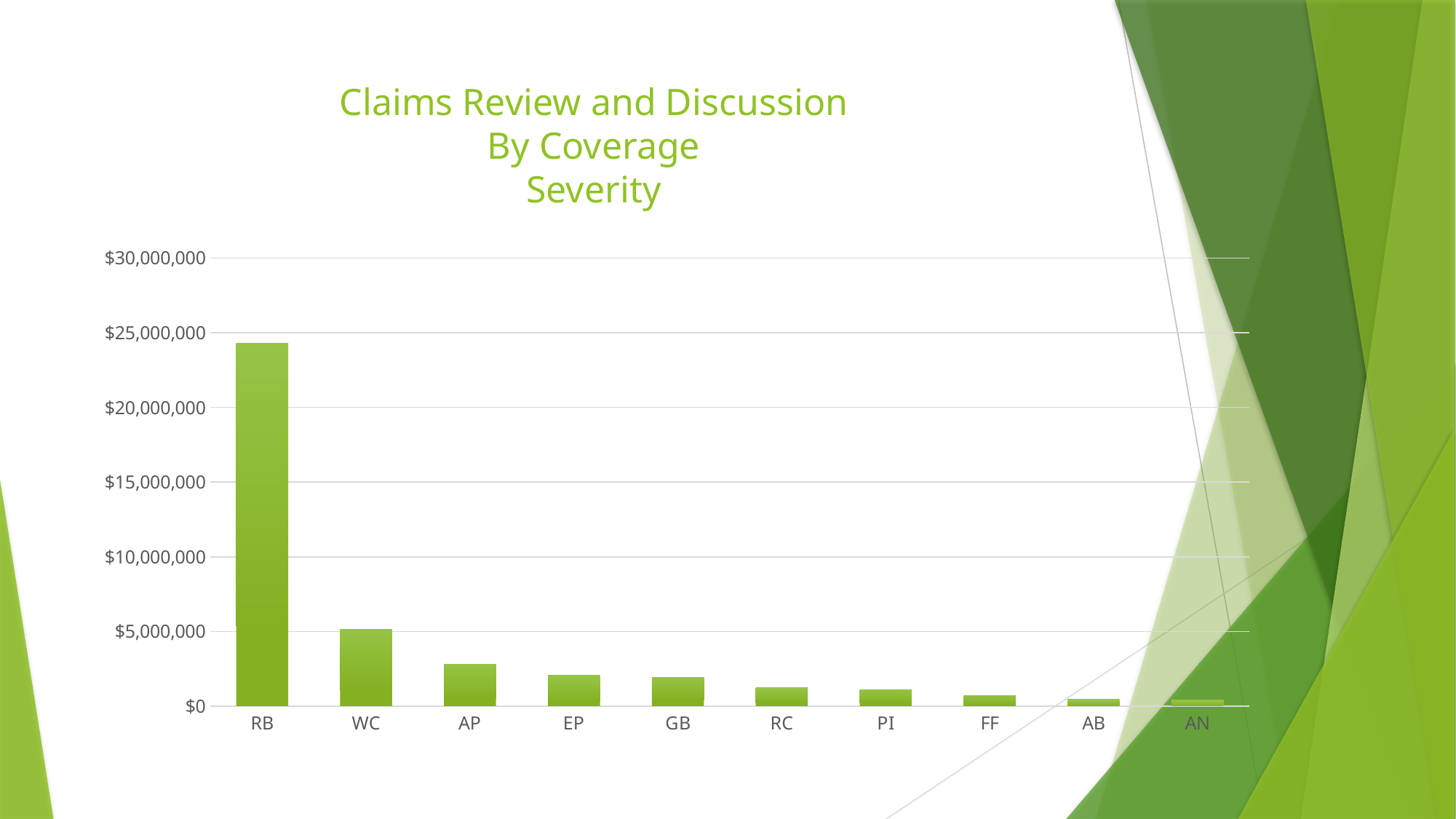
Which coverage category has the highest severity? RB Which has a larger severity value, AP or FF? AP Is the value for AP greater or less than $5,000,000? less What is the title of the chart on the slide? Claims Review and Discussion By Coverage Severity Do the bar values rise or fall moving from left to right along the x axis? fall Which has a larger severity value, RB or WC? RB Is the value for WC greater or less than $10,000,000? less Which coverage category has the lowest severity? AN What kind of chart is shown on the slide? bar chart Is the value for RB greater or less than $25,000,000? less How many coverage categories are plotted on the x axis? 10